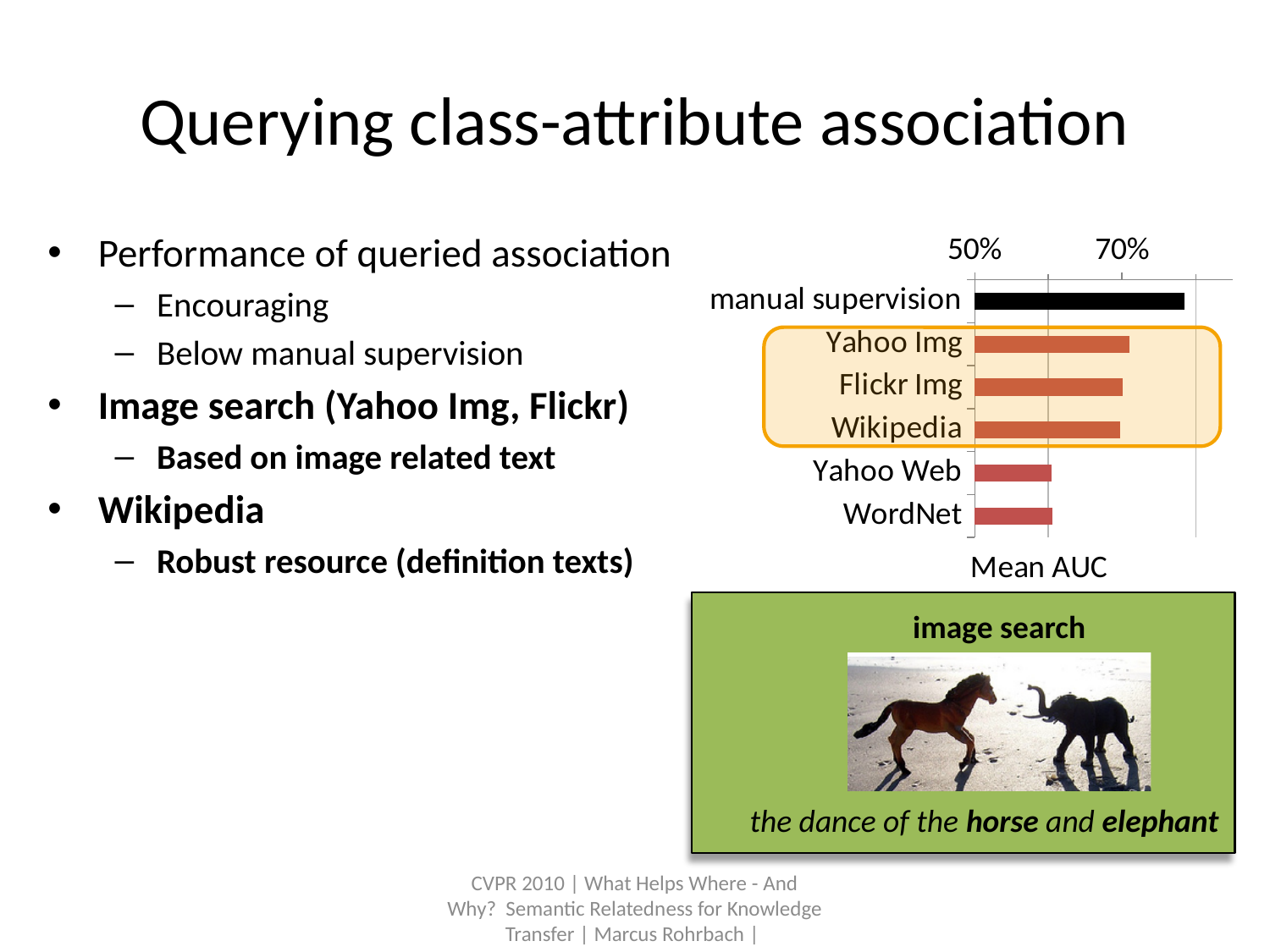
Is the value for manual supervision greater or less than 70%? greater What quantity does the horizontal axis of the bar chart measure? Mean AUC What kind of chart is shown on the slide? bar chart Is the value for WordNet greater or less than 50%? greater How many categories are plotted in the bar chart? 6 Is the value for WordNet greater or less than 70%? less Which has a higher Mean AUC, Yahoo Img or Yahoo Web? Yahoo Img Which has a higher Mean AUC, manual supervision or Wikipedia? manual supervision Which category has the highest Mean AUC in the bar chart? manual supervision